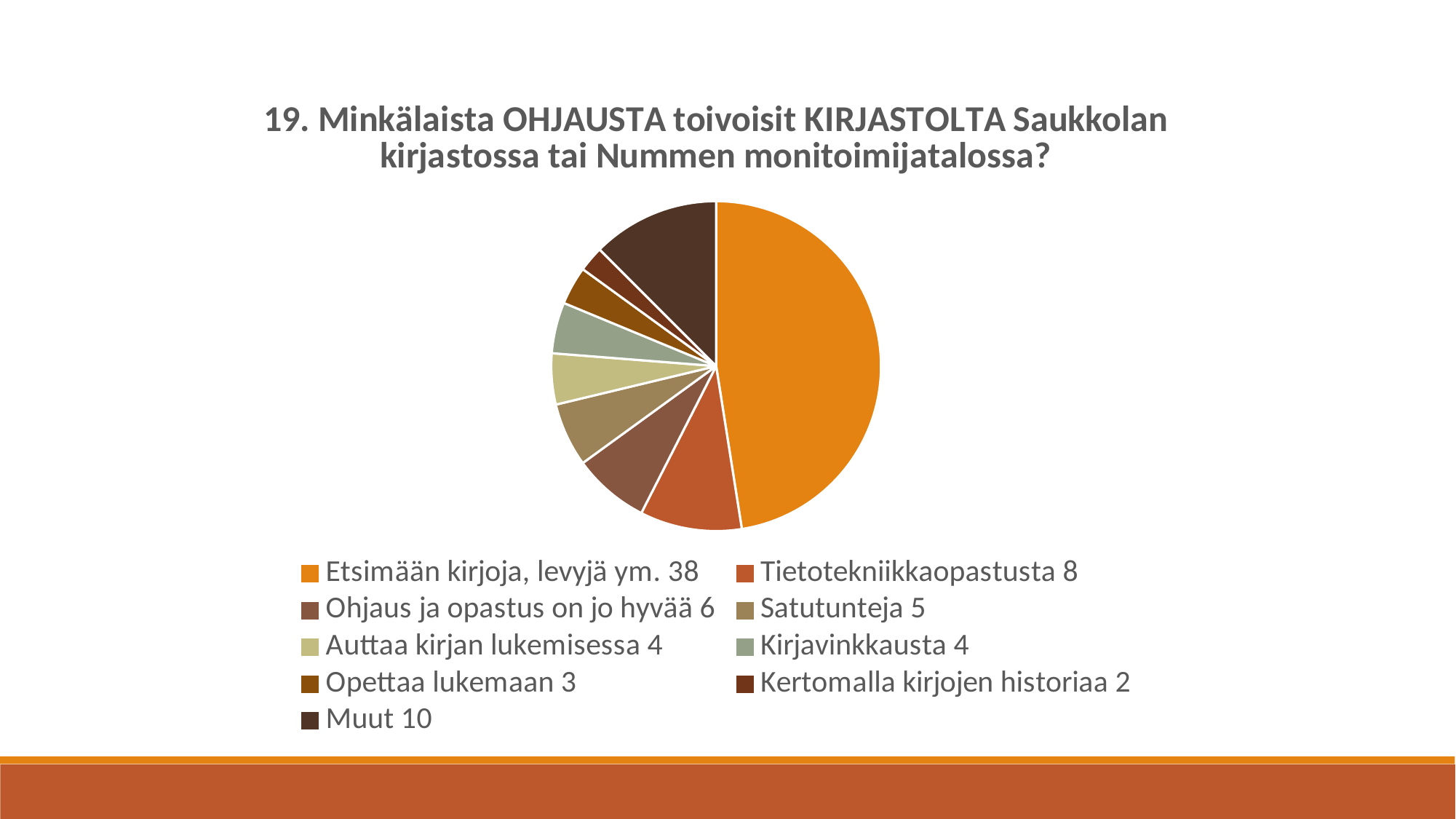
What is the value for "Tietotekniikkaopastusta"? 8 What share of the pie does "Etsimään kirjoja, levyjä ym." represent? 47.5% How many categories does the pie chart have? 9 Which category has the smallest slice of the pie? Kertomalla kirjojen historiaa What is the value for "Muut"? 10 Which category has the largest slice of the pie? Etsimään kirjoja, levyjä ym. What kind of chart is shown on the slide? pie chart What is the value for "Etsimään kirjoja, levyjä ym."? 38 What is the title of the chart? 19. Minkälaista OHJAUSTA toivoisit KIRJASTOLTA Saukkolan kirjastossa tai Nummen monitoimijatalossa? Which is larger, the value for "Satutunteja" or the value for "Ohjaus ja opastus on jo hyvää"? Ohjaus ja opastus on jo hyvää What is the value for "Kertomalla kirjojen historiaa"? 2 What is the difference between the values for "Etsimään kirjoja, levyjä ym." and "Muut"? 28